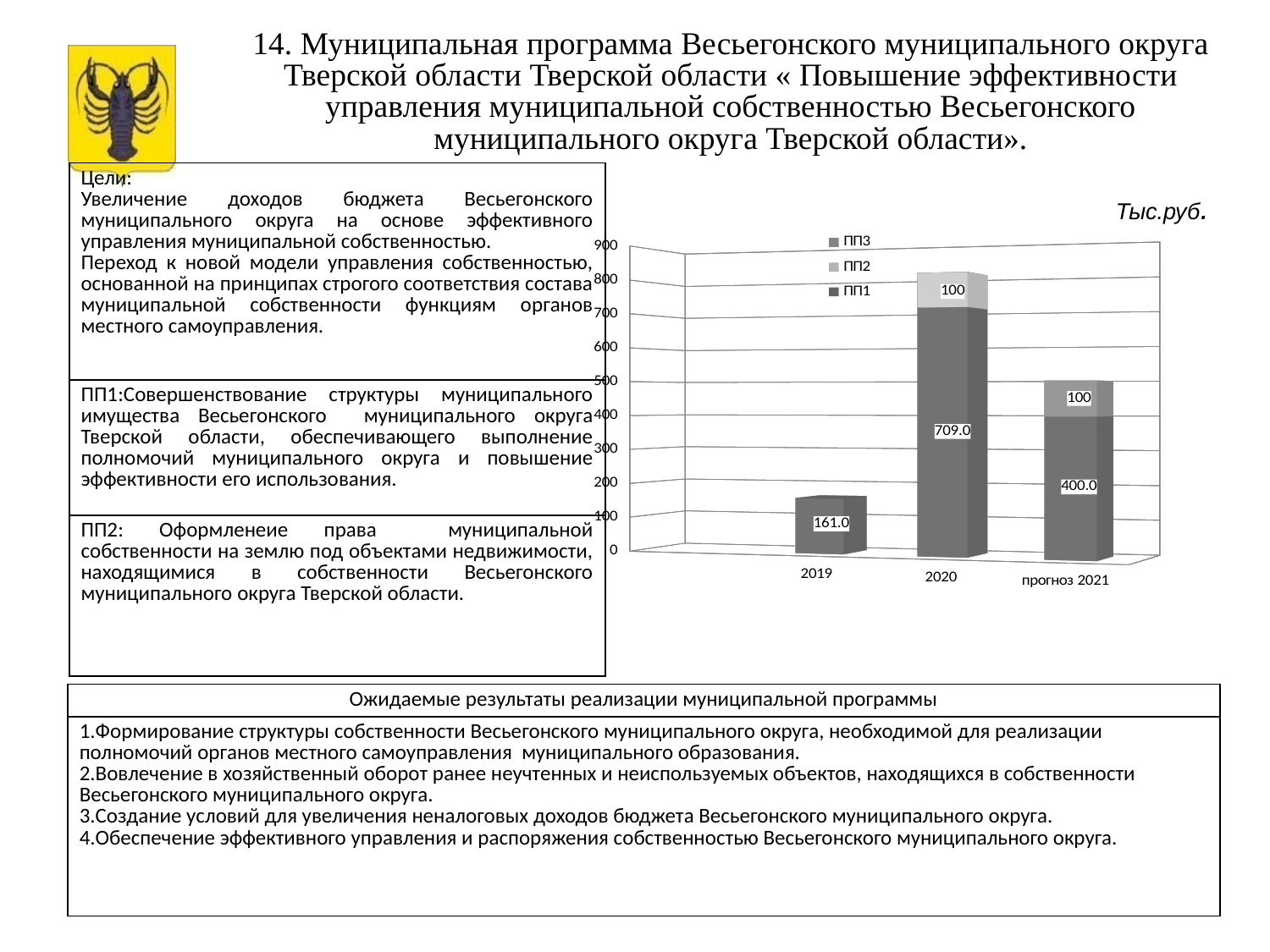
What is the value of ПП1 for прогноз 2021? 400.0 What is the value of ПП1 for 2019? 161.0 Which category has the highest value for ПП1? 2020 What type of chart is shown on the slide? bar chart What is the value of ПП1 for 2020? 709.0 What unit is indicated for the chart values? Тыс.руб. What is the total of the stacked bar for 2020? 809.0 Which category has the lowest value for ПП1? 2019 How many series does the chart legend list? 3 What is the difference between the ПП1 values for 2020 and прогноз 2021? 309.0 What is the value of ПП2 for 2020? 100 How many categories are shown on the x axis of the chart? 3